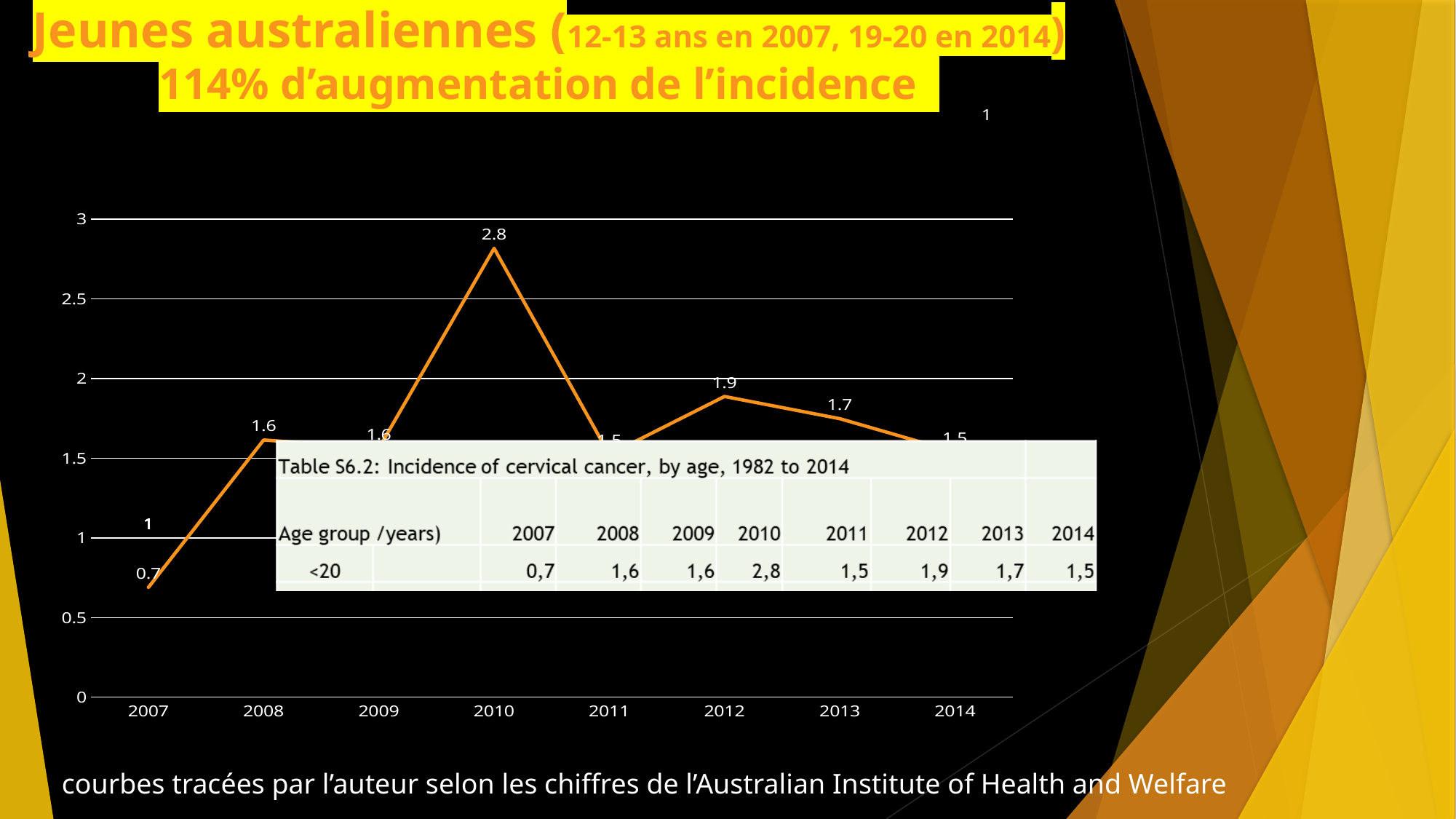
What is the value plotted for 2010? 2.8 What is the value plotted for 2013? 1.7 Is the value for 2010 greater or less than 2.5? greater How many years are plotted on the x axis? 8 What is the value plotted for 2012? 1.9 What is the value plotted for 2007? 0.7 Which year has the lowest value on the chart? 2007 Which is larger, the value for 2012 or the value for 2013? 2012 What is the difference between the values for 2010 and 2007? 2.1 Which year has the highest value on the chart? 2010 What type of chart is shown on the slide? line chart Does the value rise or fall from 2007 to 2008? rise